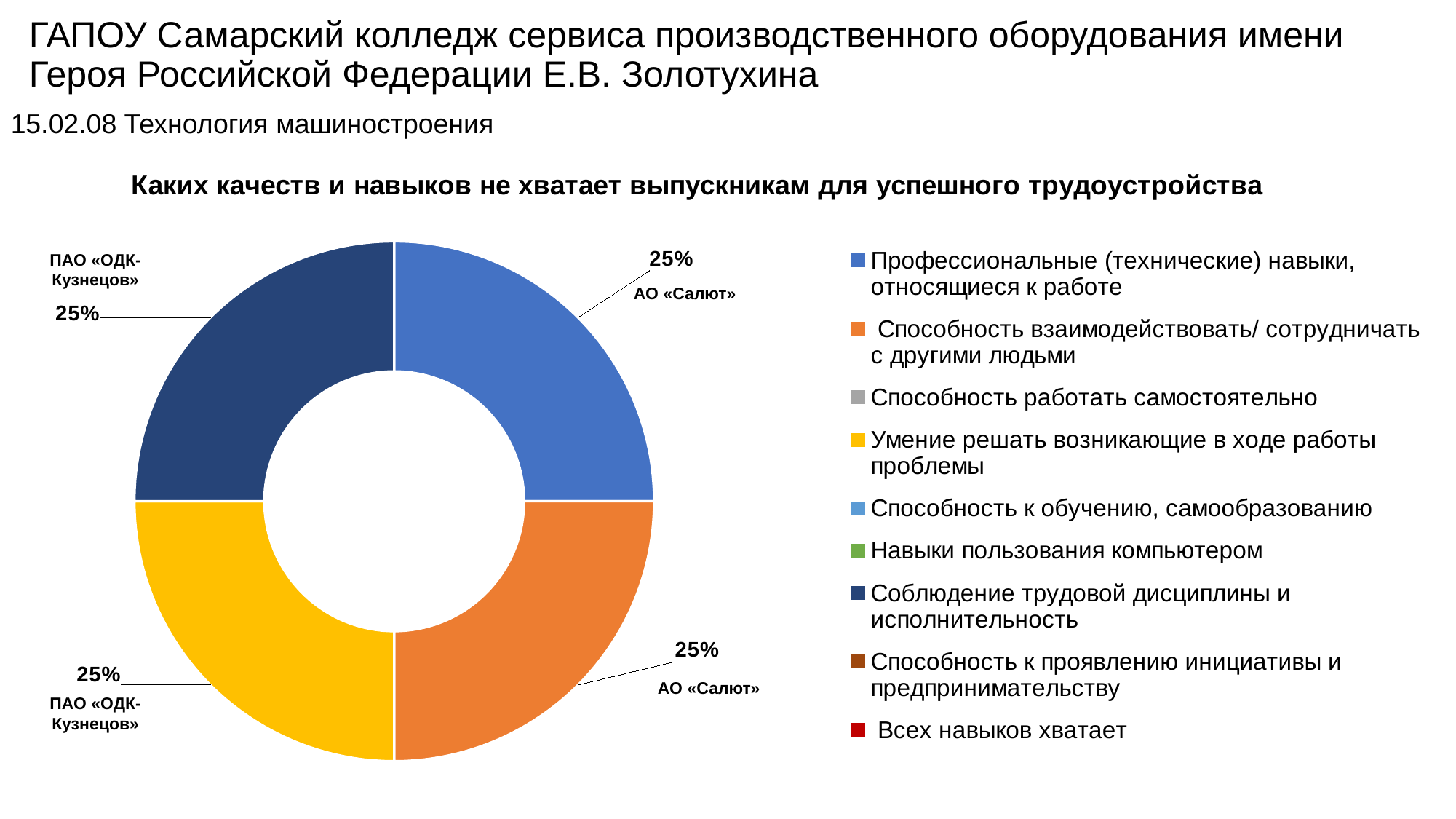
What is the title of the chart? Каких качеств и навыков не хватает выпускникам для успешного трудоустройства How many slices are visible in the doughnut chart? 4 Is the slice for «Профессиональные (технические) навыки» larger than, smaller than, or equal to the slice for «Умение решать возникающие в ходе работы проблемы»? Equal What value is shown for the slice «Соблюдение трудовой дисциплины и исполнительность»? 25% What colour is the slice for «Умение решать возникающие в ходе работы проблемы»? Yellow What is the difference between the value for «Соблюдение трудовой дисциплины и исполнительность» and the value for «Способность взаимодействовать/ сотрудничать с другими людьми»? 0% What value is shown for the slice «Умение решать возникающие в ходе работы проблемы»? 25% How many entries does the legend list? 9 What kind of chart is shown on the slide? Doughnut (pie) chart What is the combined share of the four visible slices? 100% What share of the chart does the slice for «Профессиональные (технические) навыки, относящиеся к работе» take? 25% What value is shown for the slice «Способность взаимодействовать/ сотрудничать с другими людьми»? 25%